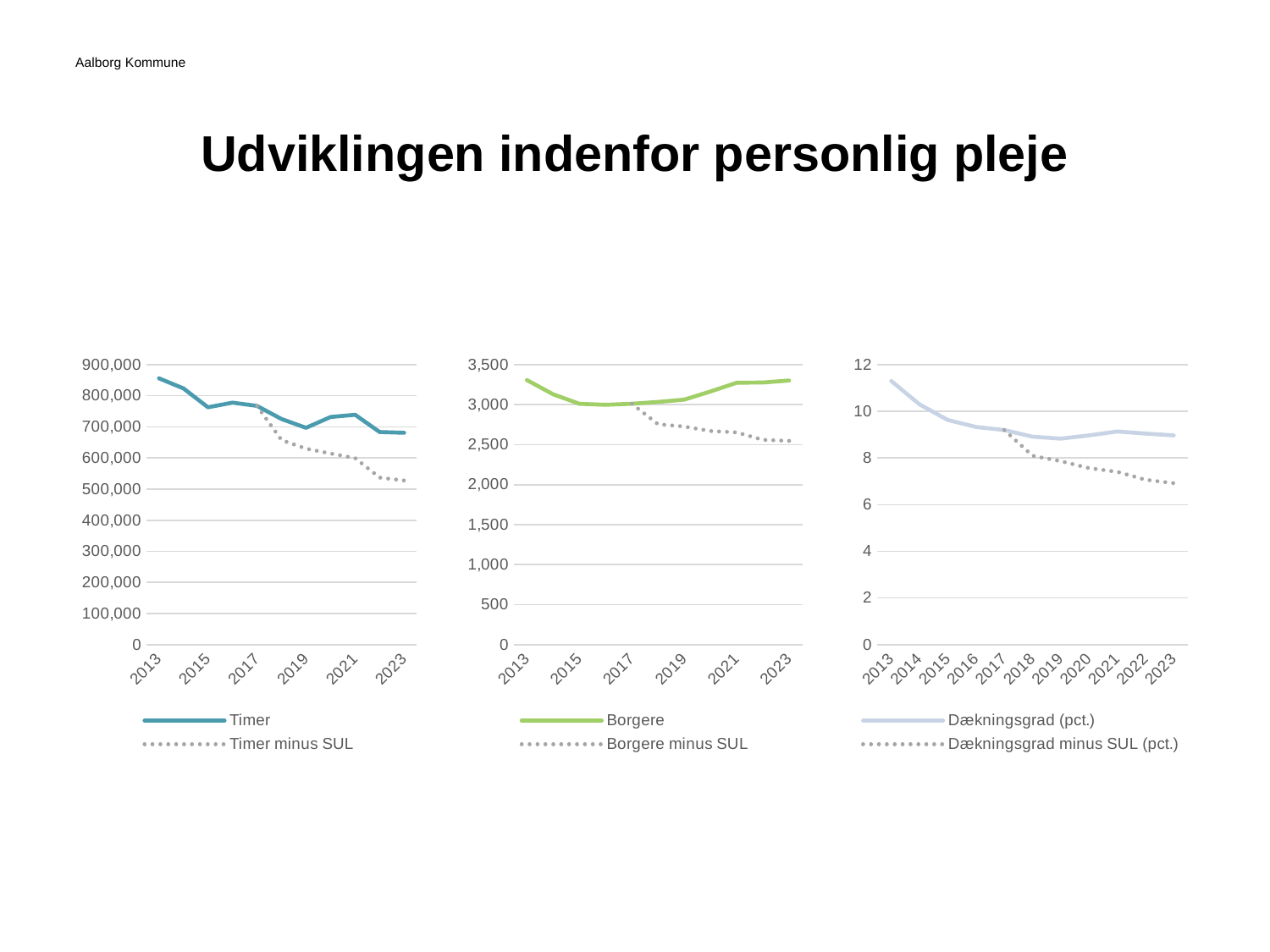
In the left chart, is the value of Timer in 2013 greater or less than 800,000? greater How many series does the legend of the middle chart (Borgere) list? 2 In the right chart, which series is higher in 2023, Dækningsgrad (pct.) or Dækningsgrad minus SUL (pct.)? Dækningsgrad (pct.) In the left chart, does the Timer series generally rise or fall from 2013 to 2023? fall In the middle chart, is the value of Borgere in 2023 greater or less than 3,000? greater What is the name of the dotted series in the middle chart's legend? Borgere minus SUL In the right chart, is the value of Dækningsgrad minus SUL (pct.) in 2023 greater or less than 8? less What kind of chart is the left chart with the Timer series? line chart